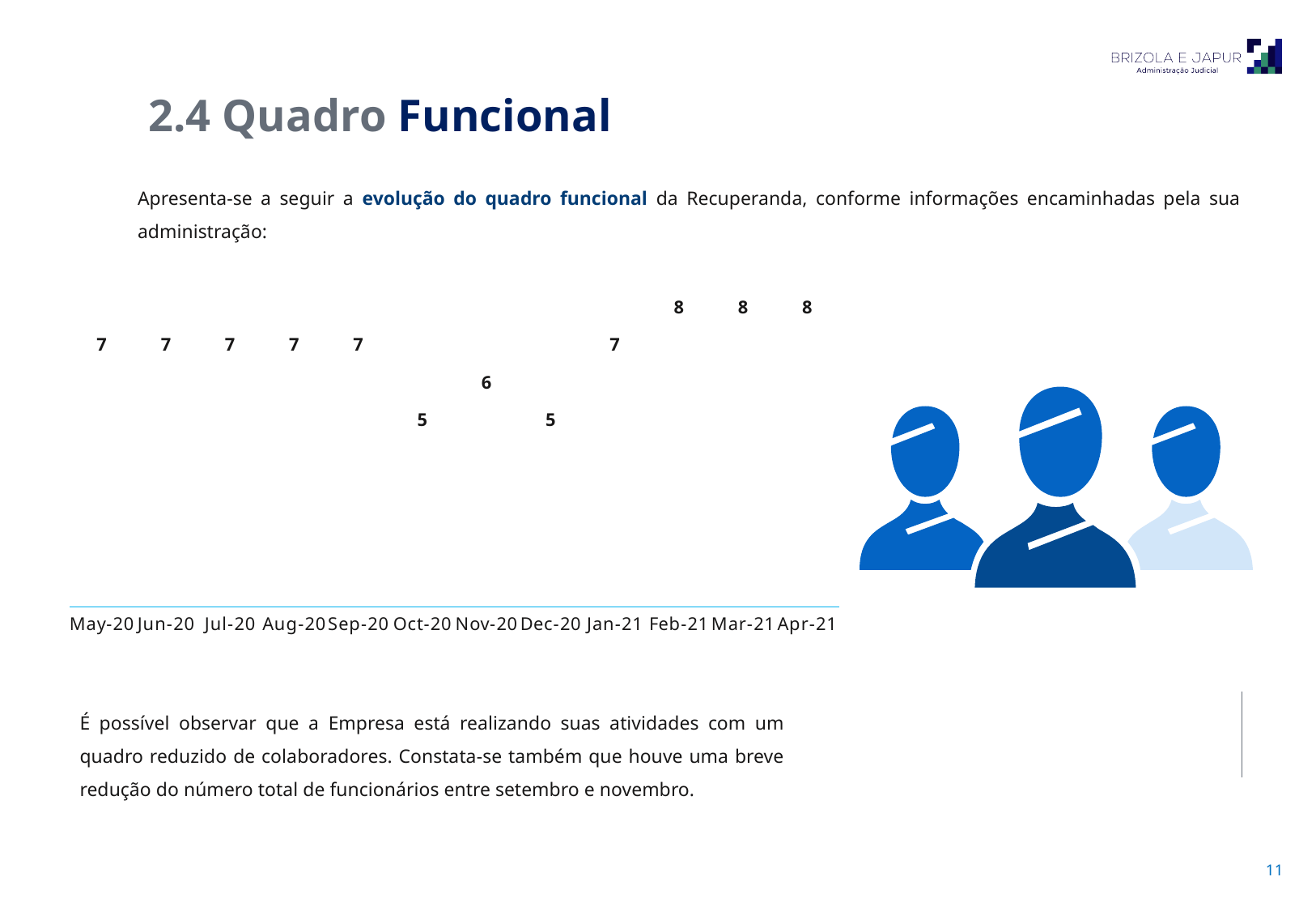
What is the difference between the value for Sep-20 and the value for Nov-20? 1 What is the value shown for Feb-21? 8 Which is larger, the value for Nov-20 or the value for Dec-20? Nov-20 What is the value shown for May-20? 7 What is the difference between the value for Apr-21 and the value for Oct-20? 3 What is the value shown for Oct-20? 5 What is the lowest value shown in the chart? 5 Do the values rise or fall from Dec-20 to Apr-21? rise What is the highest value shown in the chart? 8 What is the value shown for Jan-21? 7 How many months are shown on the x axis of the chart? 12 What is the value shown for Nov-20? 6